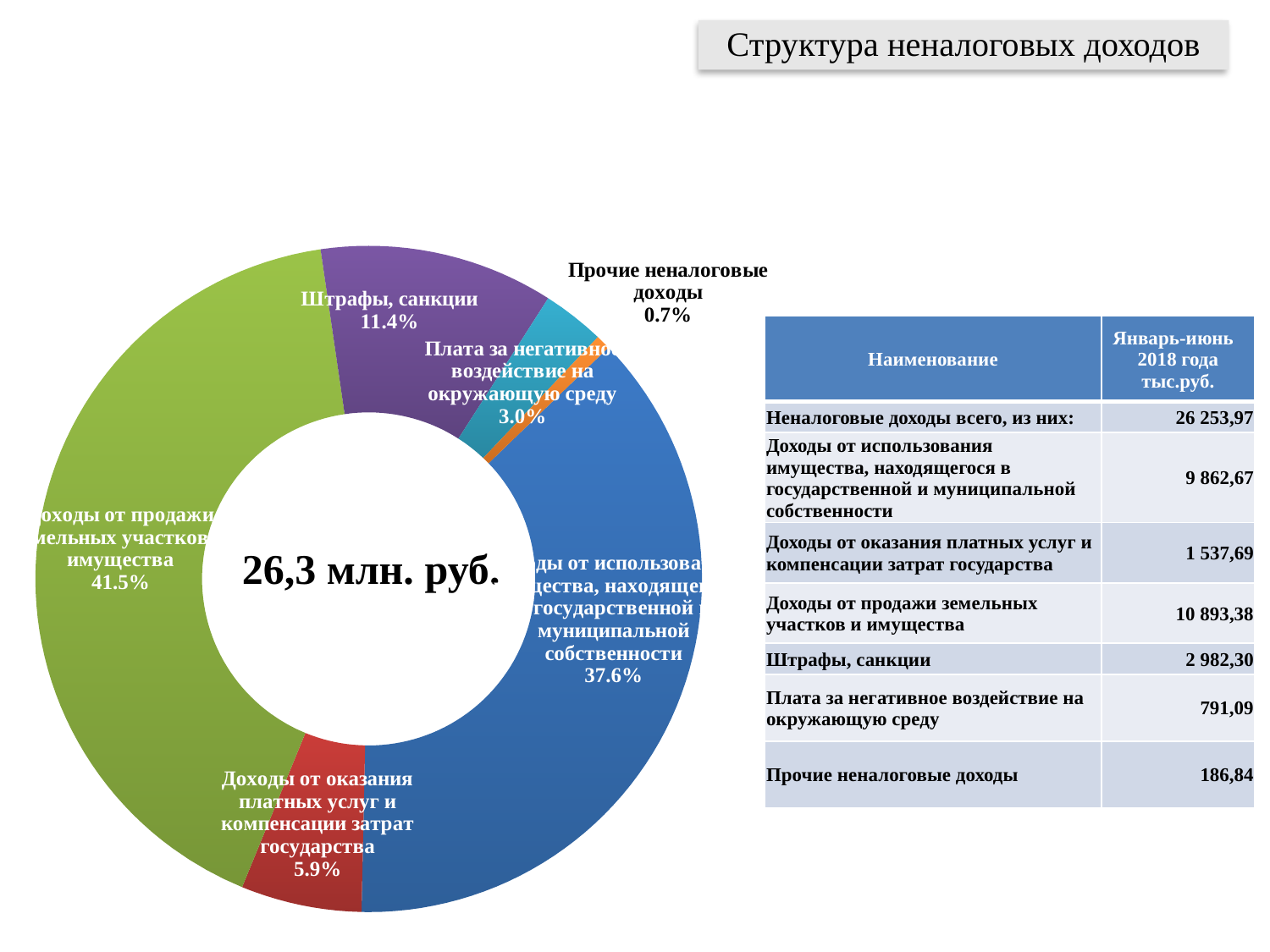
What total value is printed in the centre of the doughnut chart? 26,3 млн. руб. What share of the doughnut chart is labelled "Плата за негативное воздействие на окружающую среду"? 3.0% What share of the doughnut chart is labelled "Прочие неналоговые доходы"? 0.7% Which slice of the doughnut chart has the largest share? Доходы от продажи земельных участков и имущества (41.5%) What share of the doughnut chart is labelled "Доходы от оказания платных услуг и компенсации затрат государства"? 5.9% What share of the doughnut chart is labelled "Штрафы, санкции"? 11.4% Which slice is larger: "Штрафы, санкции" or "Доходы от оказания платных услуг и компенсации затрат государства"? Штрафы, санкции What type of chart is shown on the slide? doughnut (pie) chart What is the difference in percentage points between the "Доходы от продажи земельных участков и имущества" slice (41.5%) and the "Доходы от использования имущества" slice (37.6%)? 3.9 percentage points Which slice of the doughnut chart has the smallest share? Прочие неналоговые доходы (0.7%) What is the title shown at the top of the slide? Структура неналоговых доходов How many slices does the doughnut chart have? 6